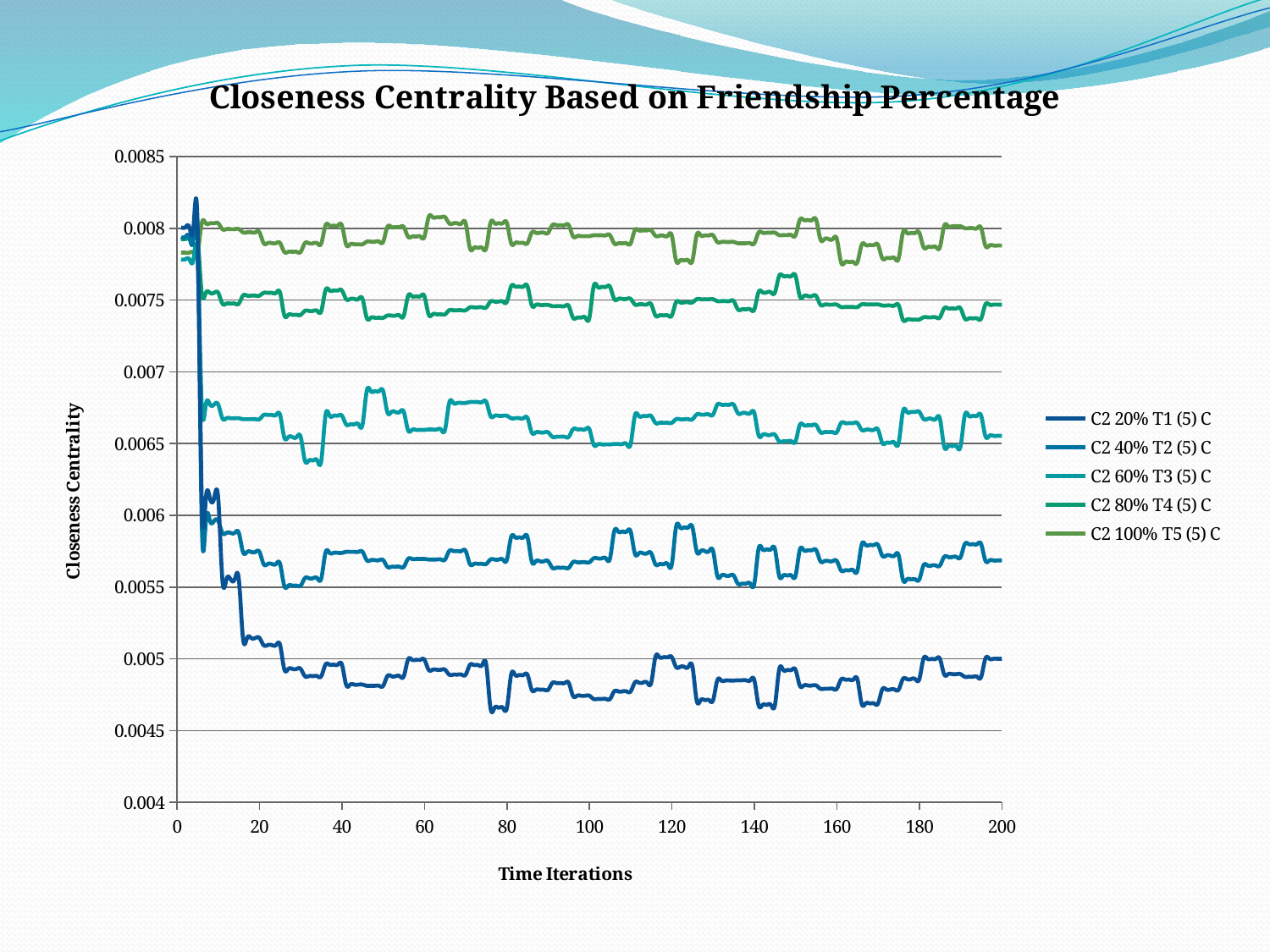
Does the C2 20% T1 (5) C series rise or fall from the start of the time iterations to the end? Fall Which series has the highest closeness centrality values across the time iterations? C2 100% T5 (5) C What is the label of the x axis? Time Iterations Is the value for C2 20% T1 (5) C at time iteration 100 greater or less than 0.005? less Is the value for C2 100% T5 (5) C at time iteration 100 greater or less than 0.0075? greater What kind of chart is shown on the slide? Line chart Is the value for C2 80% T4 (5) C at time iteration 180 greater or less than 0.007? greater What is the title of the chart? Closeness Centrality Based on Friendship Percentage At time iteration 100, which series has the larger value: C2 60% T3 (5) C or C2 40% T2 (5) C? C2 60% T3 (5) C Which series has the lowest closeness centrality values across the time iterations? C2 20% T1 (5) C How many series does the legend list? 5